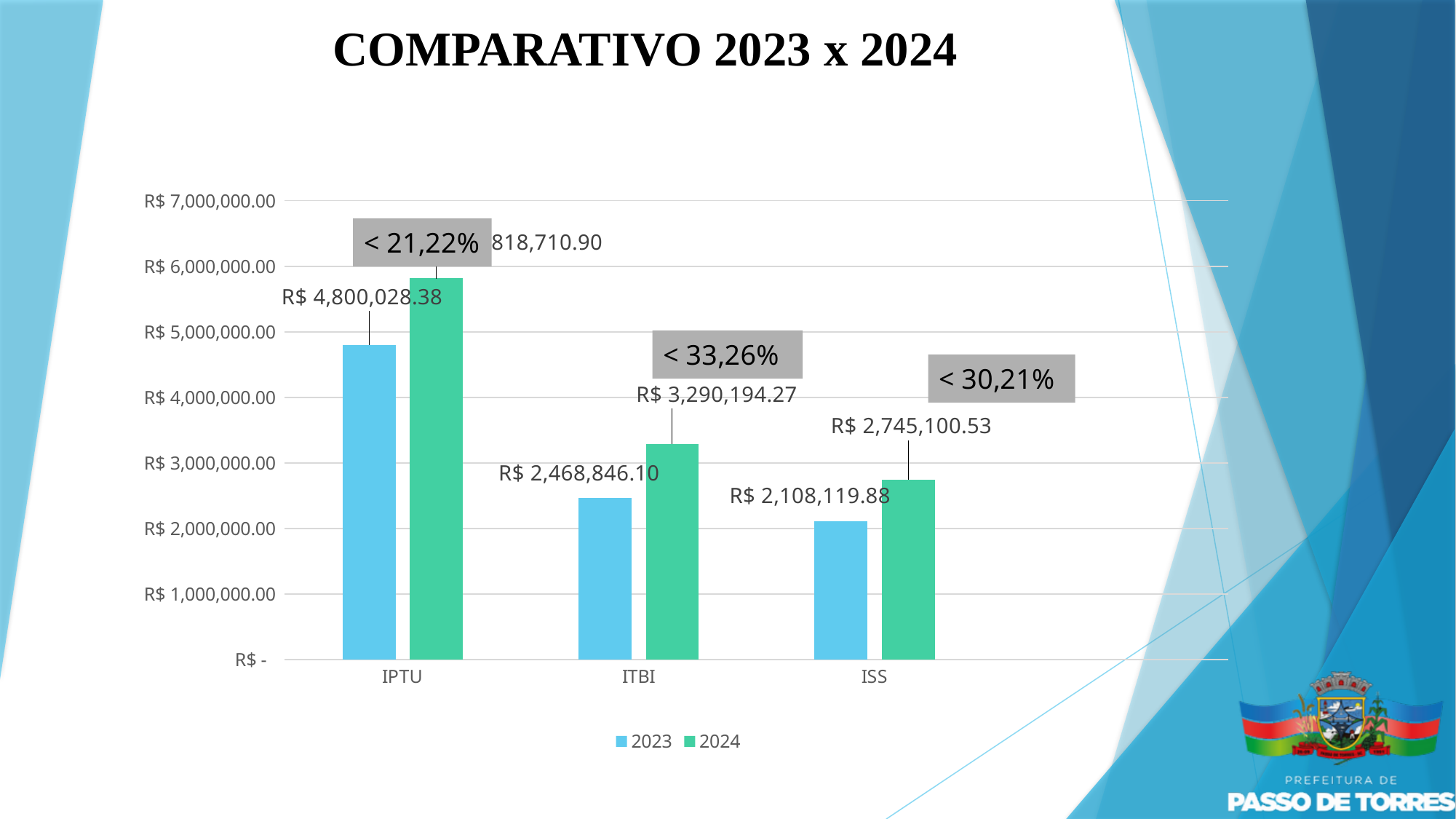
What percentage label is shown in the grey box above the IPTU bars? < 21,22% What type of chart is shown on the slide? bar chart What is the difference between the 2024 and 2023 values for ITBI? R$ 821,348.17 What is the 2024 value for ITBI? R$ 3,290,194.27 How many series does the legend list? 2 What is the 2024 value for ISS? R$ 2,745,100.53 What is the 2023 value for ISS? R$ 2,108,119.88 Is the 2024 value for IPTU greater or less than R$ 5,000,000.00? greater What is the 2023 value for IPTU? R$ 4,800,028.38 Which category has the lowest 2023 value? ISS Which category has the highest 2024 value? IPTU What is the 2023 value for ITBI? R$ 2,468,846.10